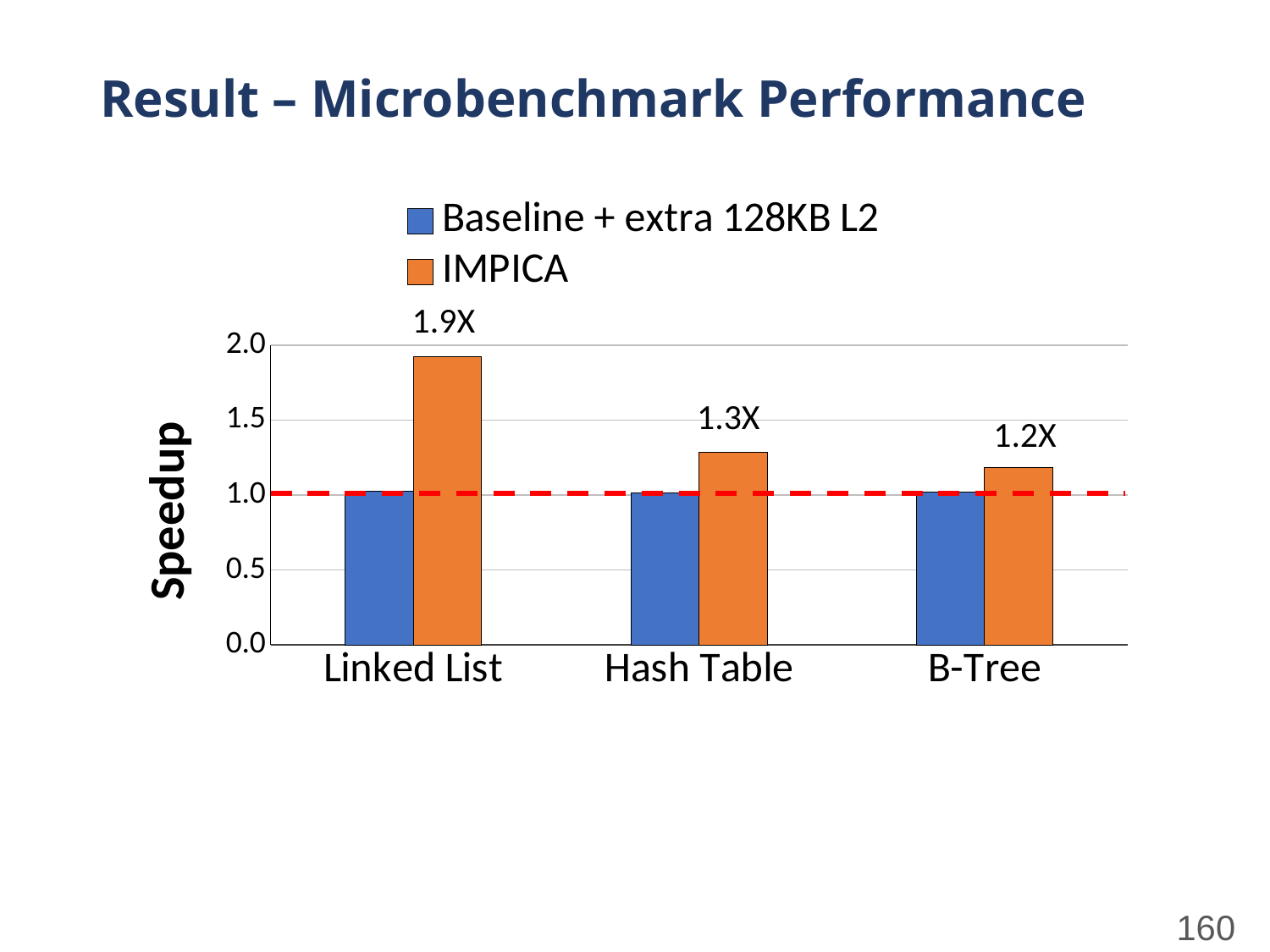
Is the IMPICA value for Linked List greater or less than 1.5? greater Is the IMPICA value for Hash Table greater or less than 1.5? less What is the label on the y axis? Speedup How many series does the legend list? 2 What is the IMPICA speedup for B-Tree? 1.2X Which has a larger IMPICA speedup, Linked List or Hash Table? Linked List How many categories are shown on the x axis? 3 What is the IMPICA speedup for Hash Table? 1.3X What is the IMPICA speedup for Linked List? 1.9X Which category has the highest IMPICA speedup? Linked List Which category has the lowest IMPICA speedup? B-Tree What kind of chart is shown on the slide? bar chart